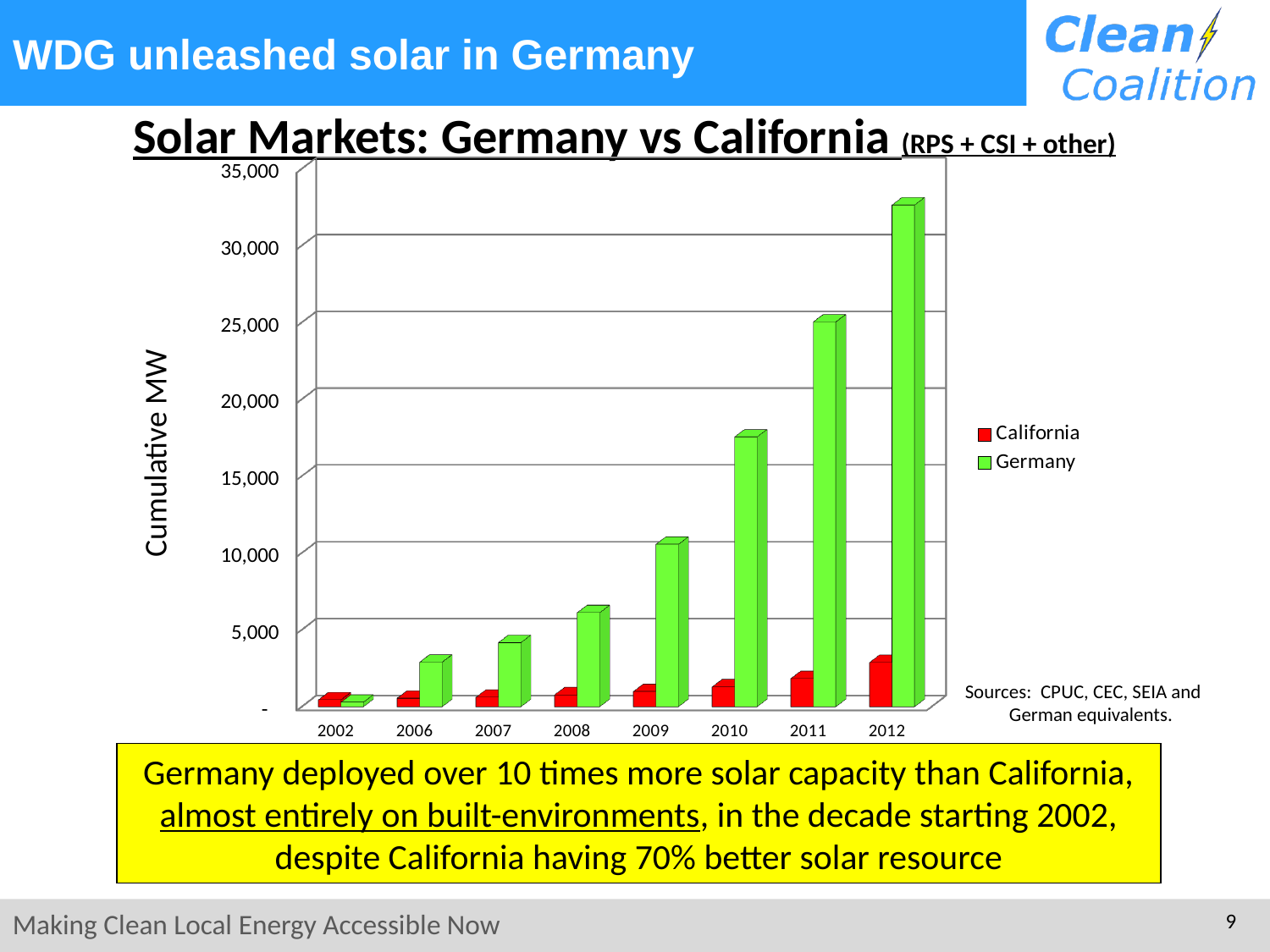
Do the Germany values rise or fall from 2002 to 2012? rise How many years are shown along the x axis of the chart? 8 In 2012, which is larger, the value for Germany or the value for California? Germany Is the value for Germany in 2012 greater or less than 30,000? greater What is the label on the chart's vertical axis? Cumulative MW In which year is the Germany bar the lowest? 2002 How many series does the chart's legend list? 2 Which colour represents Germany in the chart's legend? green What kind of chart is shown on the slide? bar chart Is the value for Germany in 2010 greater or less than 15,000? greater Is the value for California in 2012 greater or less than 5,000? less In which year is the Germany bar the highest? 2012